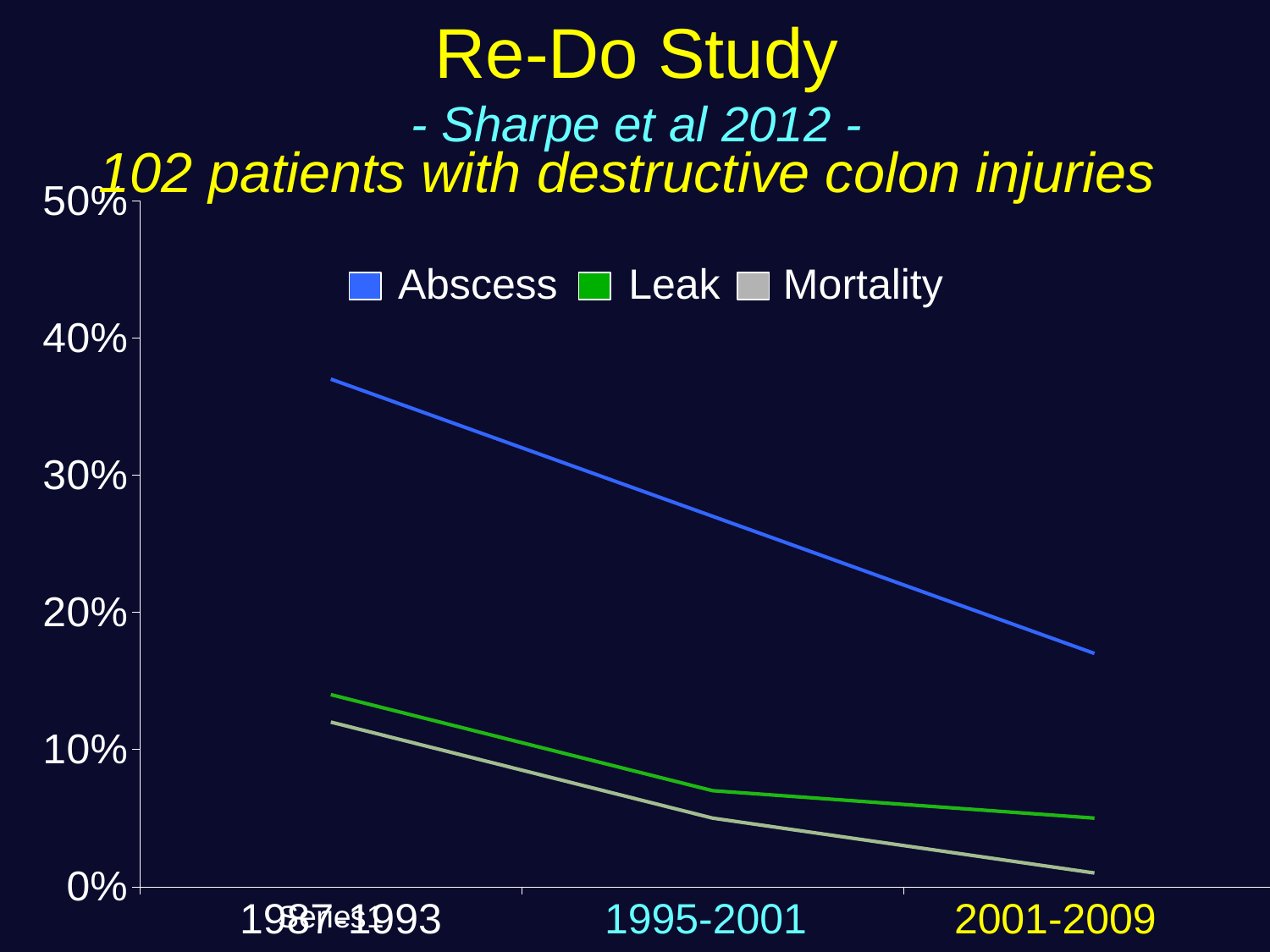
Is the Leak value for 1995-2001 greater or less than 10%? less How many series does the legend list? 3 Do the Abscess values rise or fall from 1987-1993 to 2001-2009? fall What kind of chart is shown on the slide? line chart Do the Mortality values rise or fall across the time periods? fall Which is larger in 1995-2001, the Abscess value or the Leak value? Abscess Which series is drawn in green? Leak Which series has the highest value in 1987-1993? Abscess Which series has the lowest value in 2001-2009? Mortality Is the Abscess value for 2001-2009 greater or less than 20%? less How many time periods are shown along the x axis? 3 Is the Abscess value for 1987-1993 greater or less than 30%? greater